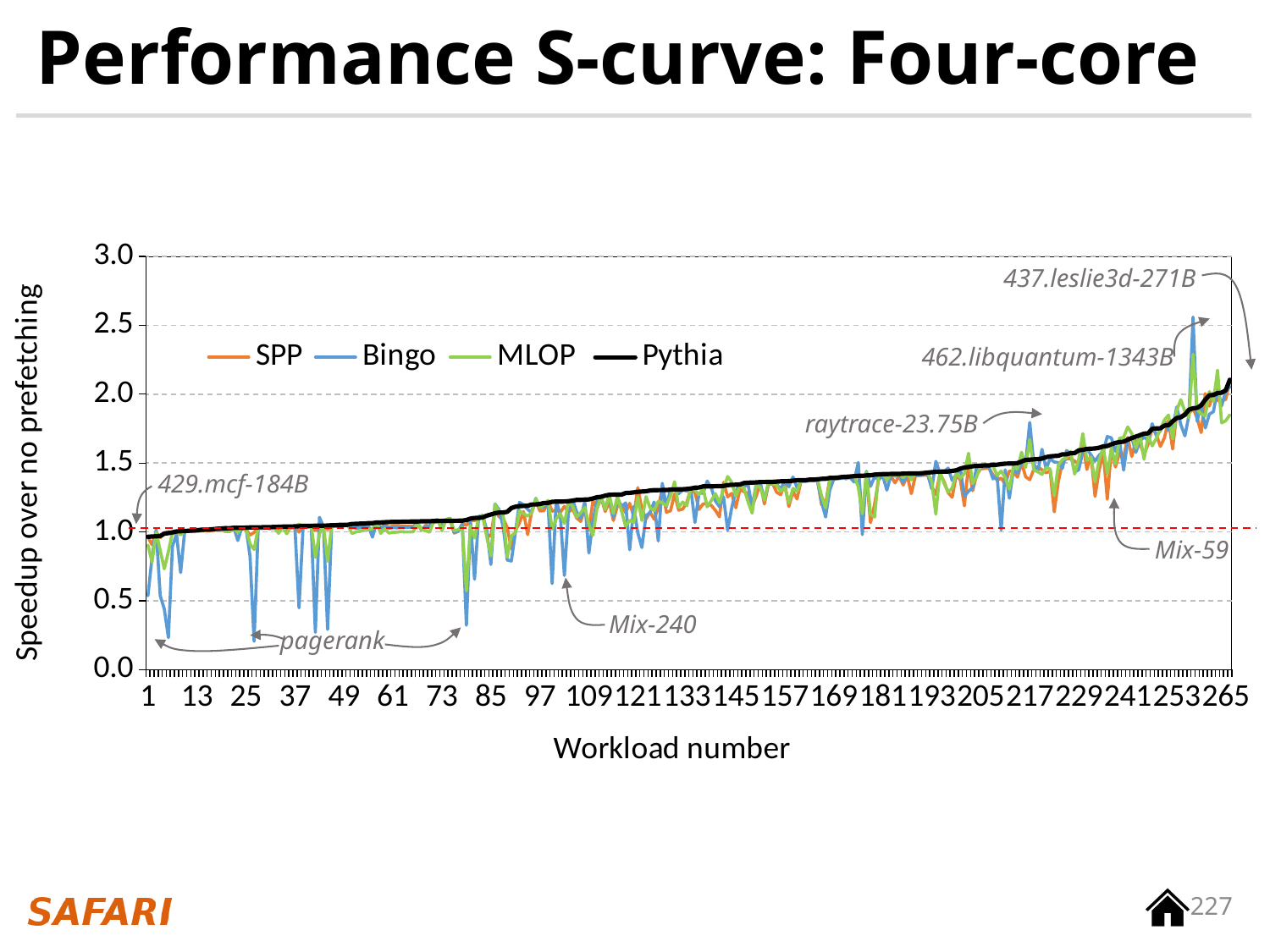
Which series are listed in the legend? SPP, Bingo, MLOP, Pythia What is the highest value shown on the y axis? 3.0 Is the Bingo value at the workload annotated 462.libquantum-1343B greater or less than 2.0? greater Does the Pythia line rise or fall as the workload number increases? rises Is the Bingo value at the workload annotated as pagerank (around workload 25) greater or less than 0.5? less Is the Pythia value at workload number 133 greater or less than 1.0? greater What is the last workload number labelled on the x axis? 265 What kind of chart is shown on the slide? line chart How many series does the legend list? 4 What is the title of the slide's chart? Performance S-curve: Four-core